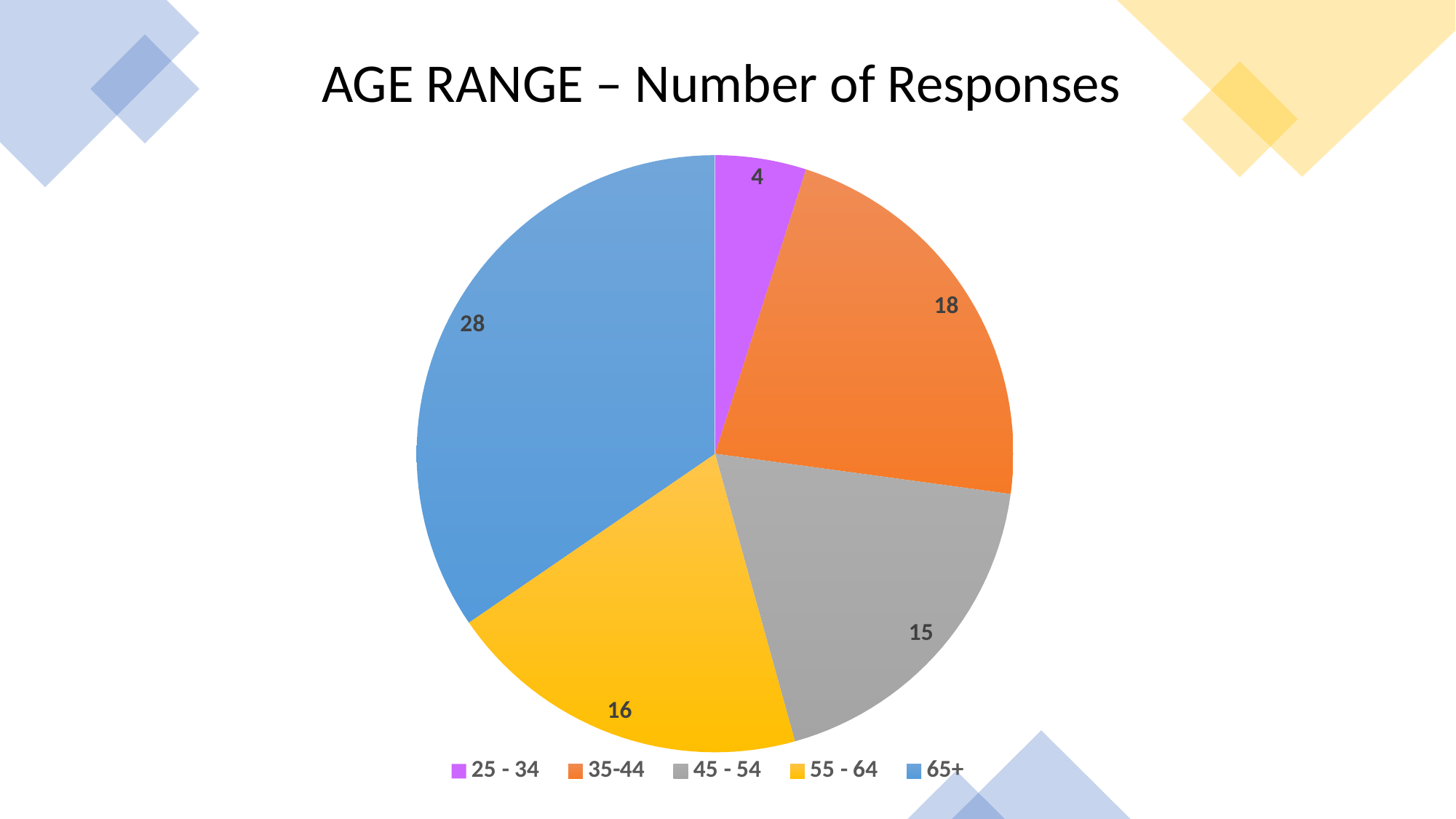
What is the difference in responses between the 65+ and 35-44 age ranges? 10 Which has more responses, the 55 - 64 or the 45 - 54 age range? 55 - 64 What type of chart is shown on the slide? Pie chart Which age range has the highest number of responses? 65+ What is the number of responses for the 65+ age range? 28 Which age range has the lowest number of responses? 25 - 34 How many age range categories are shown in the pie chart? 5 What is the number of responses for the 45 - 54 age range? 15 What is the number of responses for the 35-44 age range? 18 What is the total number of responses across all age ranges? 81 What is the number of responses for the 25 - 34 age range? 4 What is the title of the chart? AGE RANGE – Number of Responses